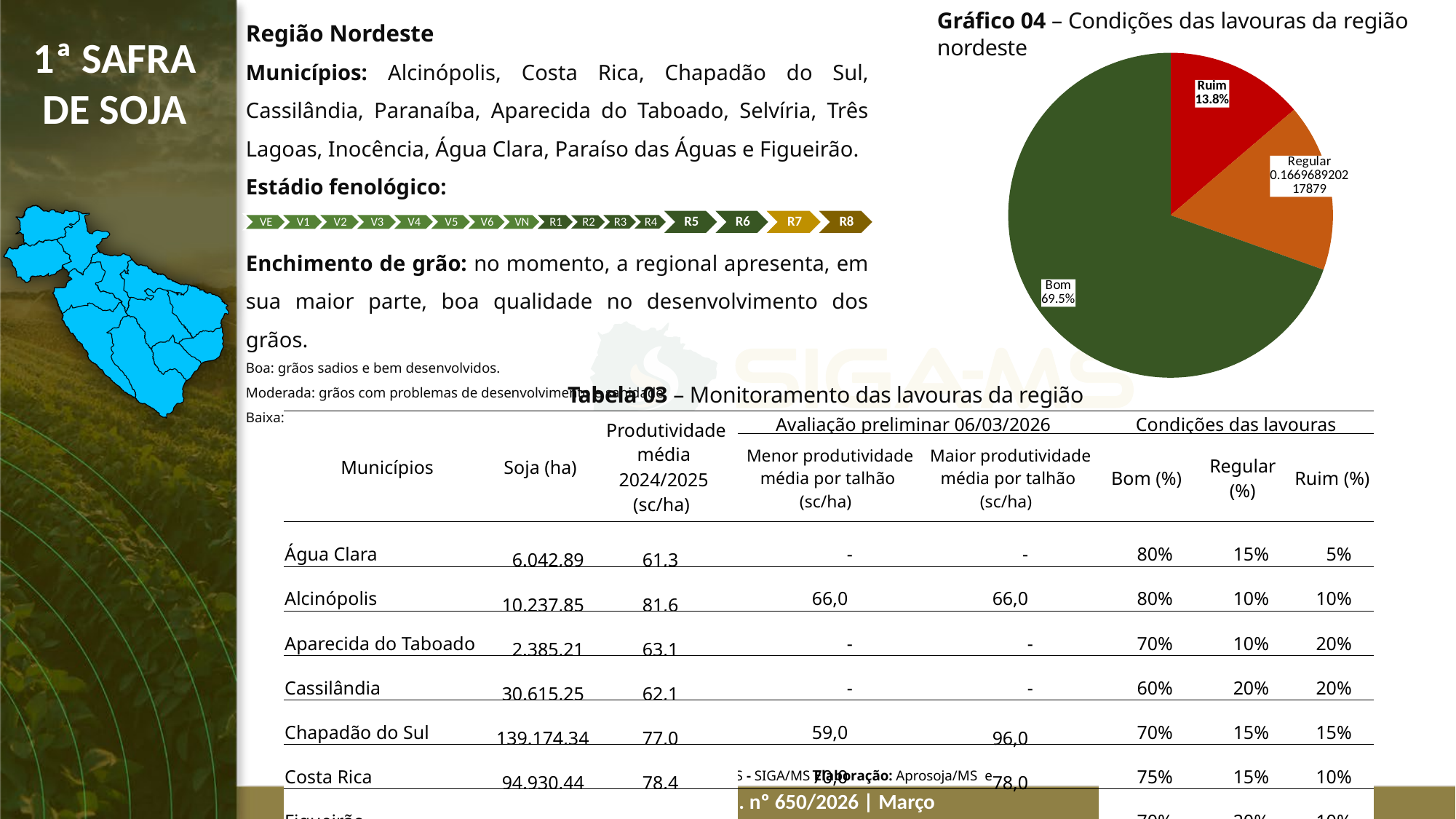
In Gráfico 04, which category has the smallest slice? Ruim In Gráfico 04, which is larger, the Bom slice or the Ruim slice? Bom How many slices does the pie in Gráfico 04 have? 3 What kind of chart is Gráfico 04? pie chart In Gráfico 04, what share of the pie does the Bom slice represent? 69.5% In Gráfico 04, what percentage of the lavouras is classified as Ruim? 13.8% What is the title of the pie chart on the slide? Gráfico 04 – Condições das lavouras da região nordeste In Gráfico 04, what percentage of the lavouras is classified as Bom? 69.5% In Gráfico 04, what colour is the Ruim slice? red In Gráfico 04, what value is printed on the Regular slice? 0.166968920217879 In Gráfico 04, what is the difference in percentage points between the Bom and Ruim slices? 55.7 In Gráfico 04, which category has the largest slice? Bom